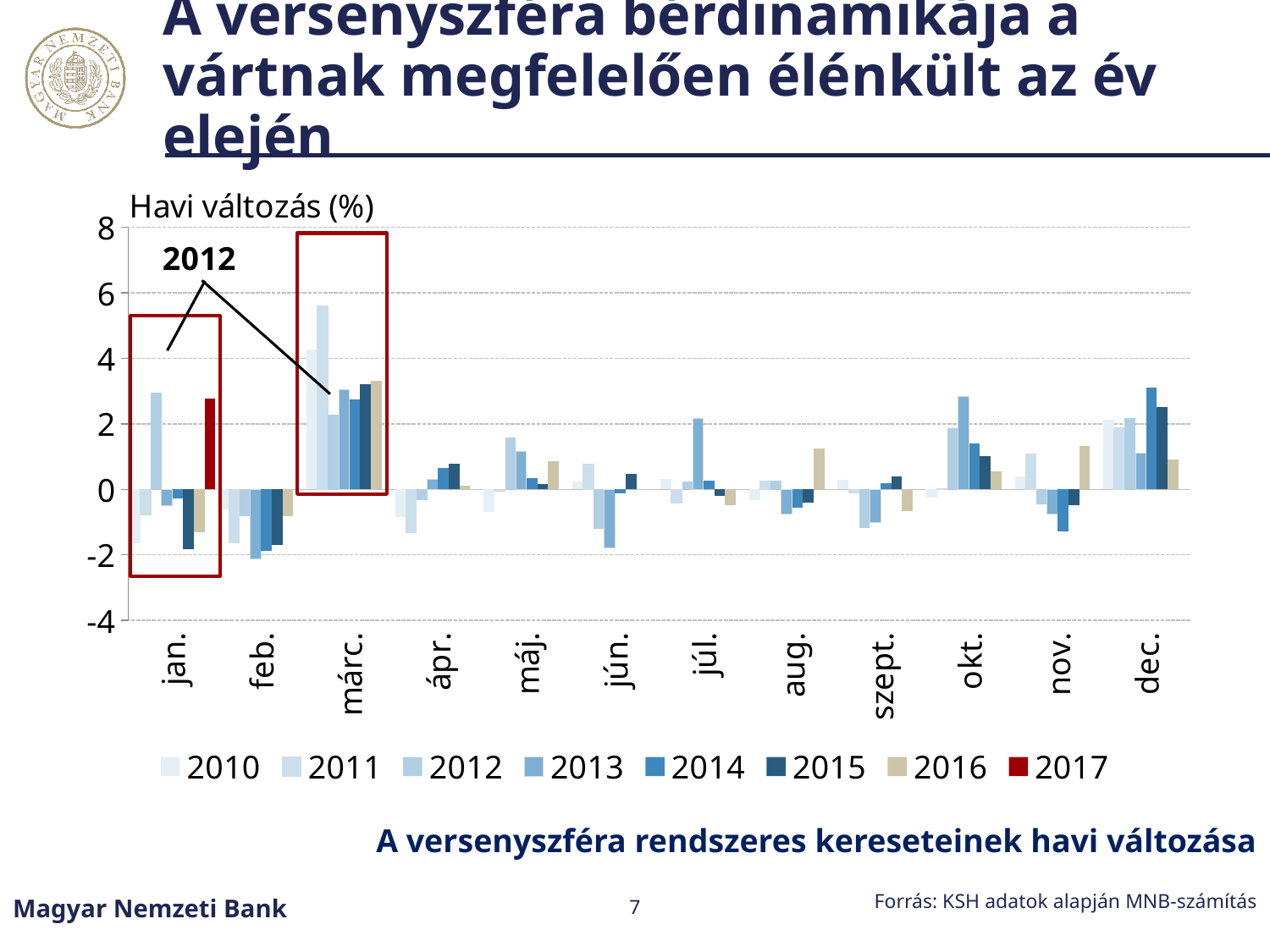
In márc., which is larger: the value for 2011 or the value for 2012? 2011 How many months are shown along the x axis? 12 What is the label on the vertical axis of the chart? Havi változás (%) How many series does the legend list? 8 What kind of chart is shown on the slide? bar chart Is the value for 2012 in jún. greater or less than 0? less Is the value for 2015 in jan. greater or less than 0? less Which series has the highest bar in márc.? 2011 In dec., which is larger: the value for 2014 or the value for 2016? 2014 Is the value for 2017 in jan. greater or less than 2? greater Which series is drawn in dark red? 2017